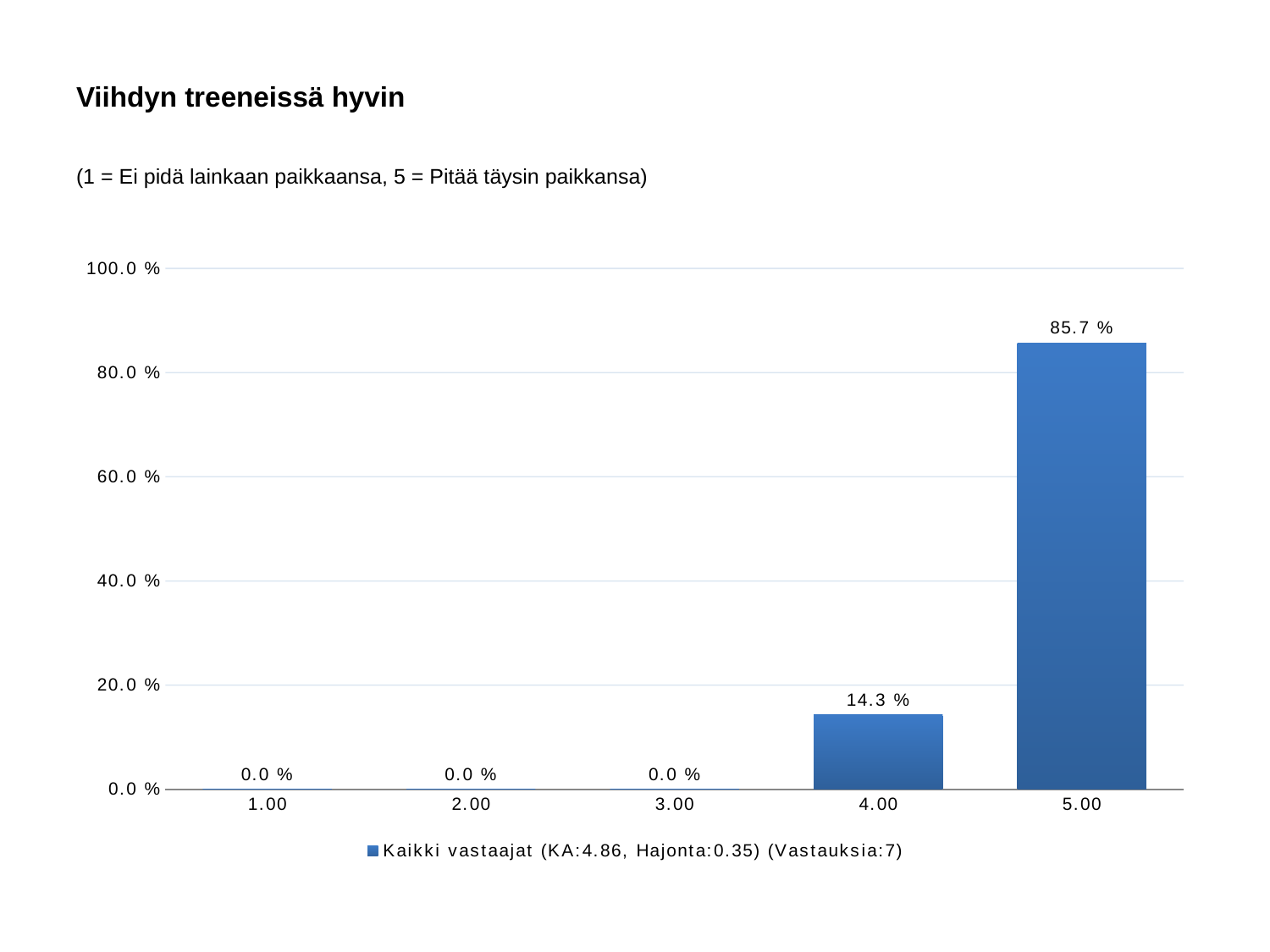
Is the value for 5.00 greater or less than 80.0 %? greater What is the value for category 5.00? 85.7 % Is the value for 4.00 greater or less than 20.0 %? less What is the value for category 4.00? 14.3 % How many series does the legend list? 1 How many categories are shown on the x axis? 5 What is the value for category 1.00? 0.0 % Which category has the highest value? 5.00 What kind of chart is shown? bar chart What is the difference between the values for 5.00 and 4.00? 71.4 % Which is larger, the value for 4.00 or the value for 5.00? 5.00 What is the title of the slide? Viihdyn treeneissä hyvin